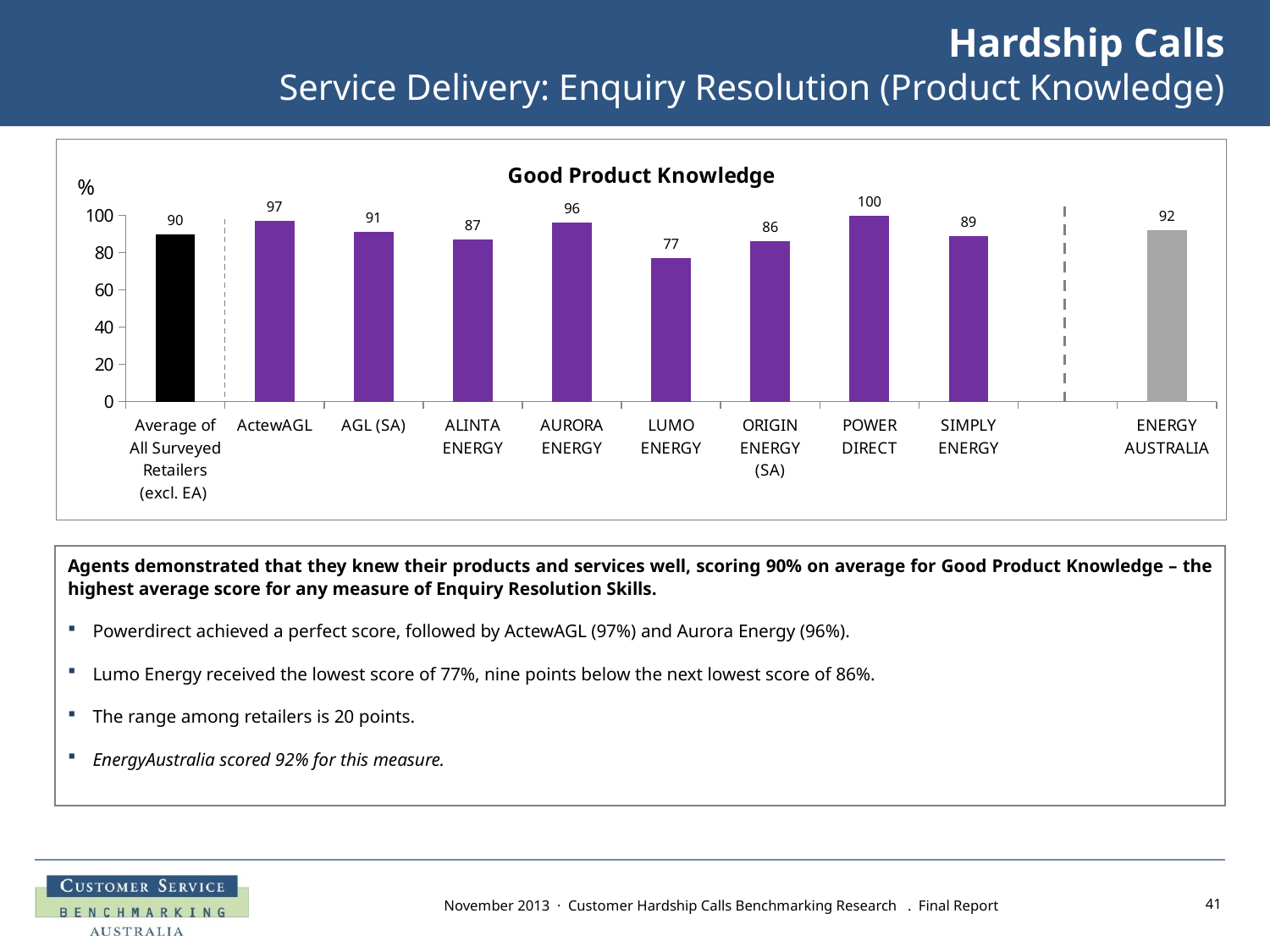
What kind of chart is shown on the slide? Bar chart Which retailer has the lowest value in the Good Product Knowledge chart? LUMO ENERGY What is the value for ENERGY AUSTRALIA in the chart? 92 Is the value for ALINTA ENERGY greater or less than 80? greater What is the value for LUMO ENERGY in the Good Product Knowledge chart? 77 What is the title of the chart on the slide? Good Product Knowledge What is the difference between the values for ActewAGL and AGL (SA)? 6 Which has a higher value, AURORA ENERGY or ORIGIN ENERGY (SA)? AURORA ENERGY What is the value for POWER DIRECT in the Good Product Knowledge chart? 100 What is the value for the Average of All Surveyed Retailers (excl. EA)? 90 Which retailer has the highest value in the Good Product Knowledge chart? POWER DIRECT How many bars are plotted in the Good Product Knowledge chart? 10